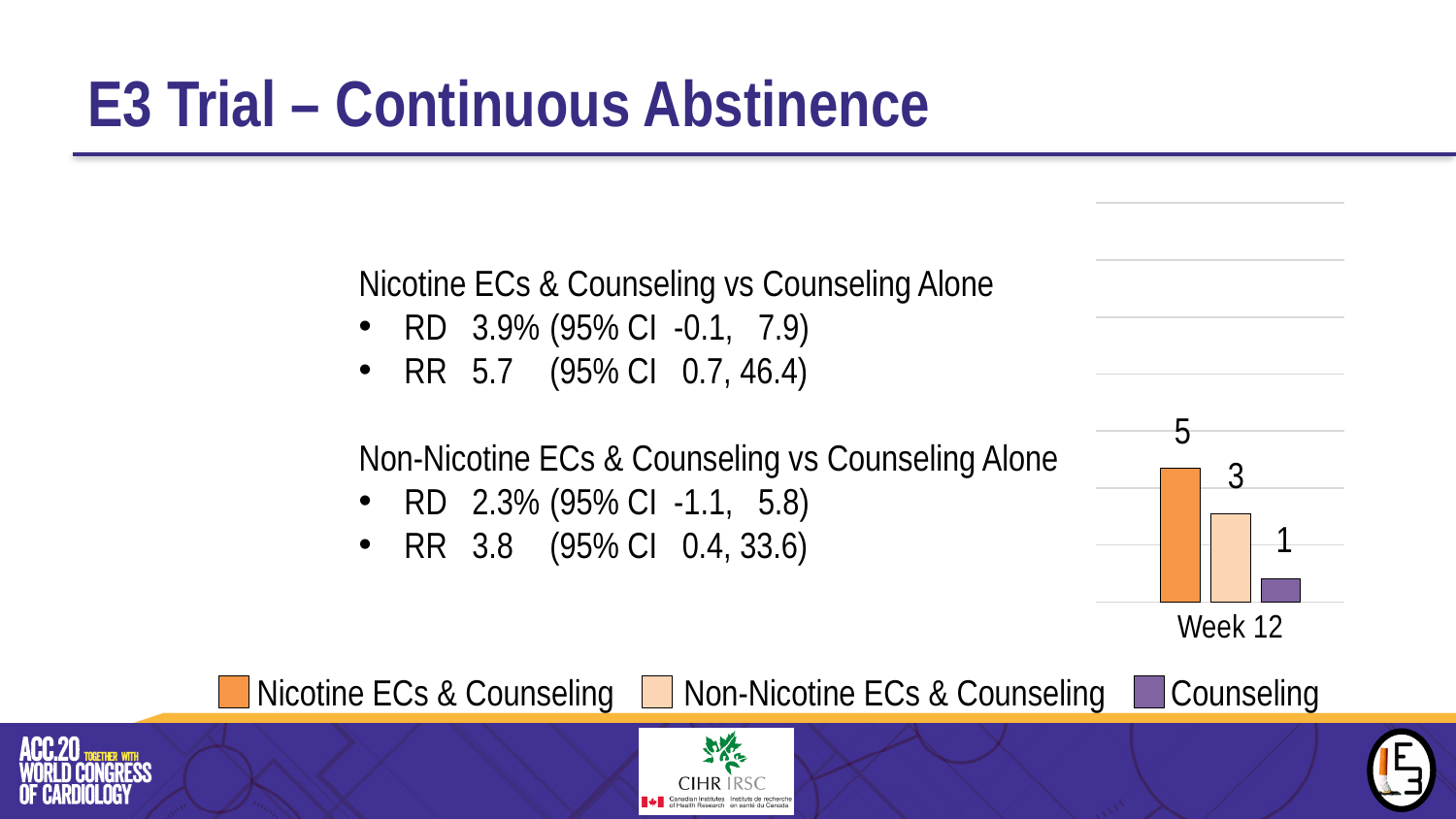
How many series does the legend list? 3 What is the difference between the Nicotine ECs & Counseling value and the Counseling value at Week 12? 4 Which is larger at Week 12: Nicotine ECs & Counseling or Non-Nicotine ECs & Counseling? Nicotine ECs & Counseling What is the value for Non-Nicotine ECs & Counseling at Week 12? 3 Which series has the highest value at Week 12? Nicotine ECs & Counseling Which series has the lowest value at Week 12? Counseling What is the value for Counseling at Week 12? 1 What colour represents the Counseling series in the chart? purple How many categories are shown on the x axis of the chart? 1 What kind of chart is shown on the slide? bar chart What is the difference between the Non-Nicotine ECs & Counseling value and the Counseling value at Week 12? 2 What is the value for Nicotine ECs & Counseling at Week 12? 5